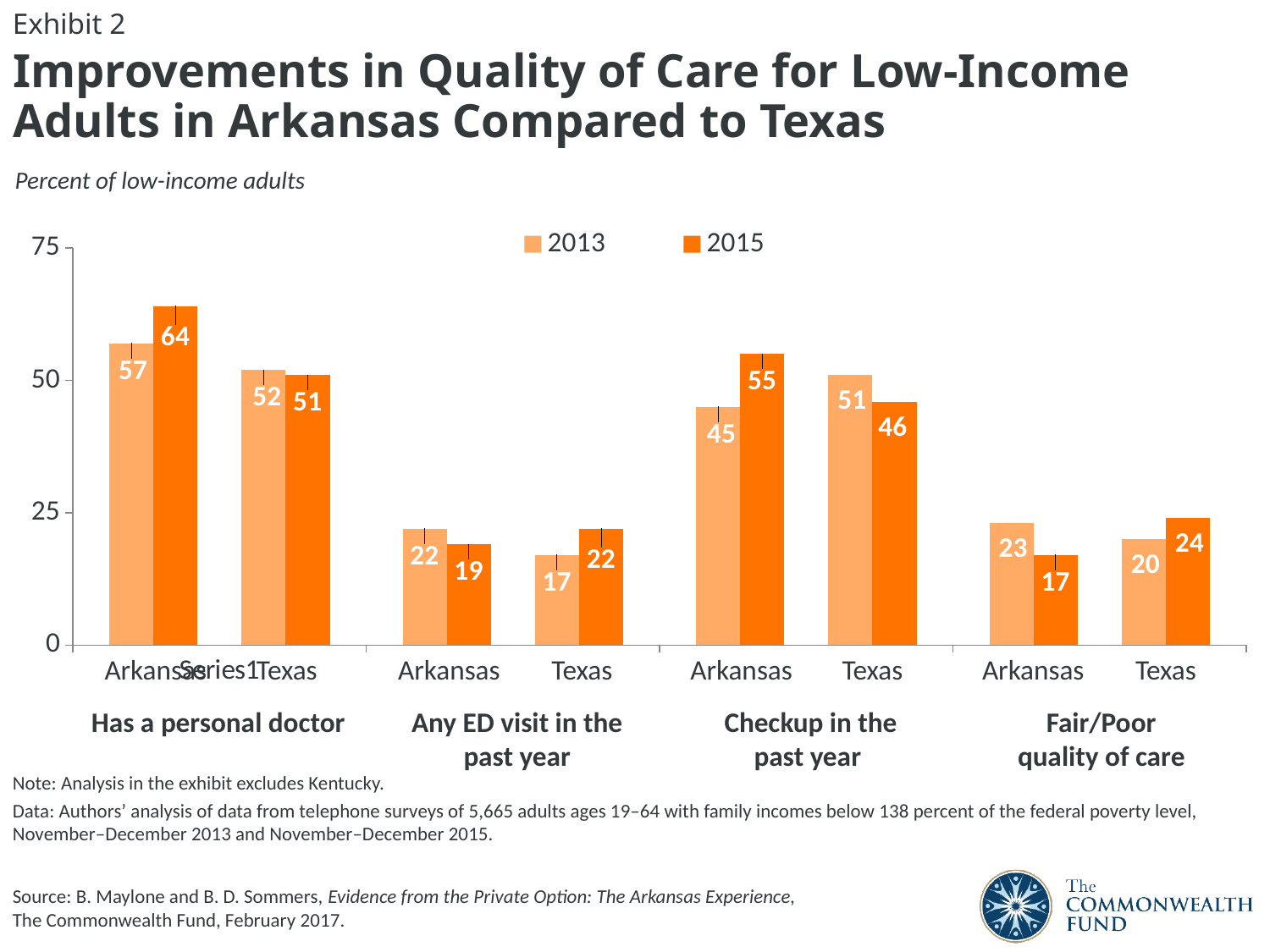
What is the 2013 value for Texas under "Any ED visit in the past year"? 17 What is the 2013 value for Texas under "Checkup in the past year"? 51 What is the 2015 value for Arkansas under "Has a personal doctor"? 64 Which bar has the highest value on the chart? Arkansas 2015, Has a personal doctor (64) Under "Fair/Poor quality of care", which is larger: the Texas 2015 value or the Arkansas 2015 value? Texas 2015 By how much did the Arkansas value for "Checkup in the past year" change from 2013 to 2015? 10 Which year does the darker orange colour represent in the legend? 2015 What is the difference between the 2013 and 2015 values for Arkansas under "Has a personal doctor"? 7 What kind of chart is shown on the slide? Bar chart What is the 2015 value for Arkansas under "Fair/Poor quality of care"? 17 Is the 2015 value for Arkansas under "Checkup in the past year" greater or less than 50? greater How many series does the legend list? 2